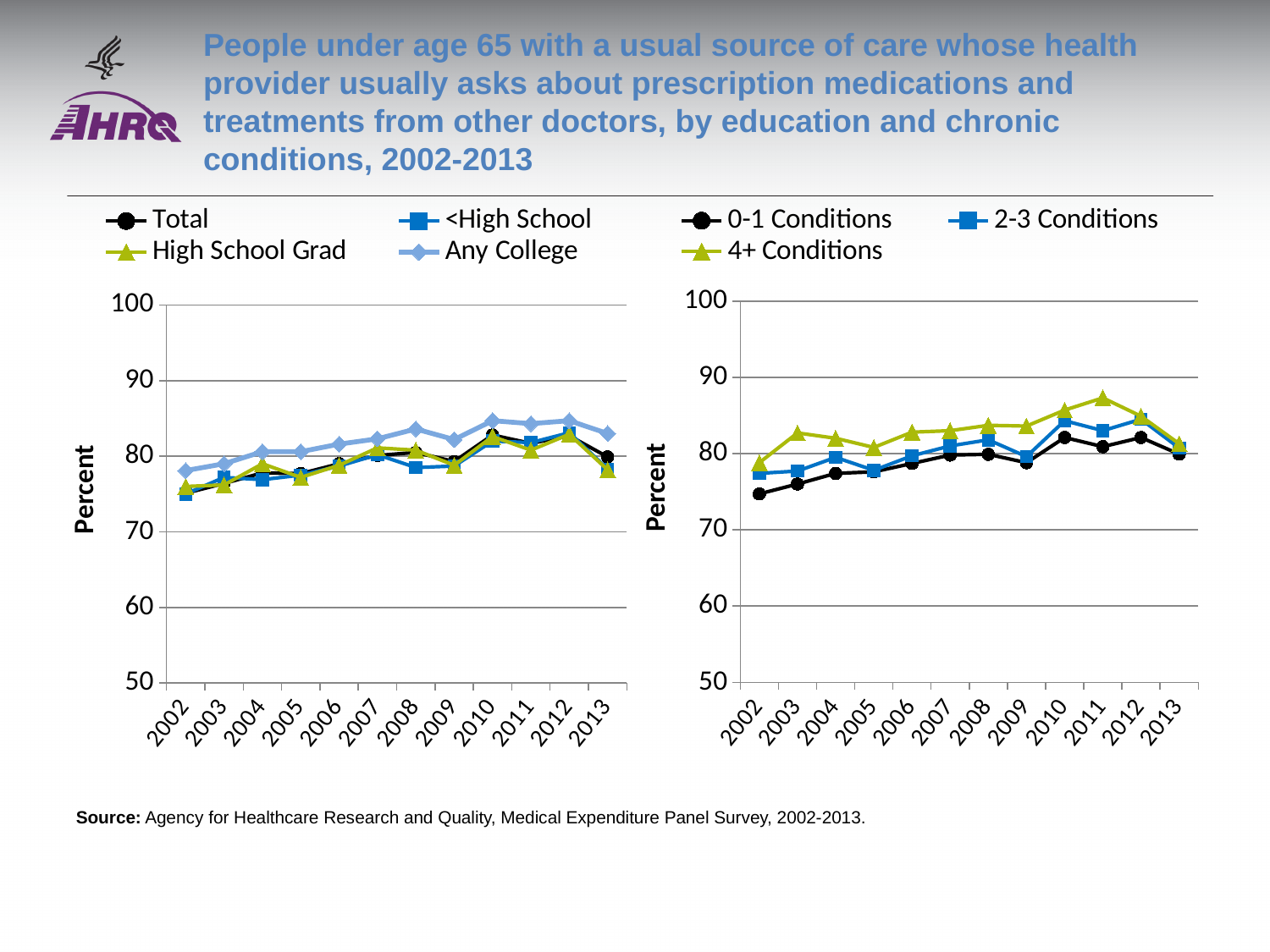
In the right chart (by chronic conditions), which is larger in 2003: 4+ Conditions or 0-1 Conditions? 4+ Conditions How many years are shown on the x axis of the right chart (by chronic conditions)? 12 In the left chart (by education), which series has the highest value in 2002? Any College How many series does the legend of the right chart (by chronic conditions) list? 3 What is the label on the y axis of both charts? Percent What kind of chart is the left chart (by education)? line chart How many series does the legend of the left chart (by education) list? 4 In the left chart (by education), is the value for Any College in 2010 greater or less than 80? greater In the right chart (by chronic conditions), does the 0-1 Conditions series generally rise or fall from 2002 to 2012? rise In the right chart (by chronic conditions), which series has the lowest value in 2002? 0-1 Conditions In the right chart (by chronic conditions), which series has the highest value in 2011? 4+ Conditions In the right chart (by chronic conditions), is the value for 0-1 Conditions in 2002 greater or less than 80? less